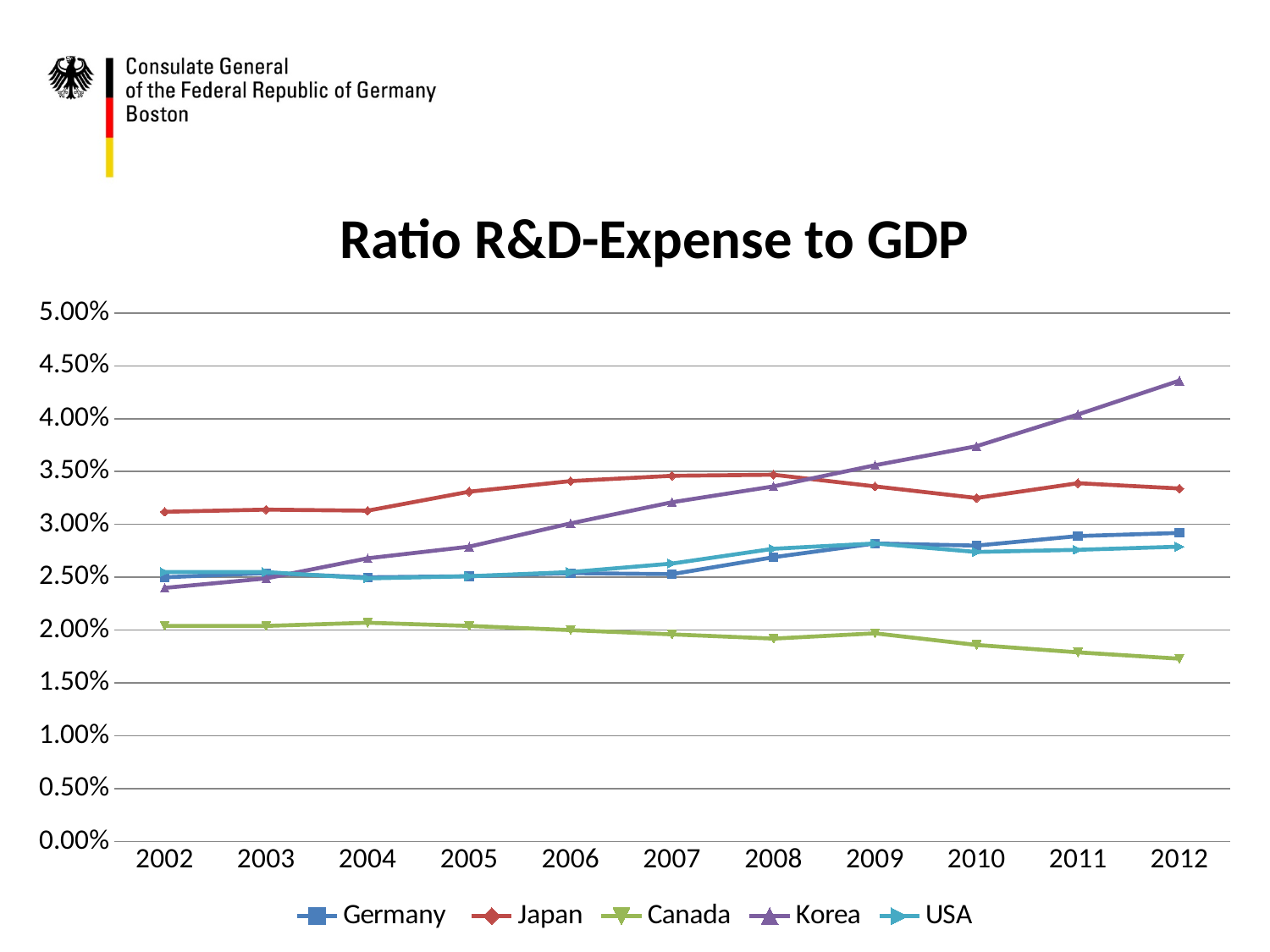
Does the value for Korea rise or fall from 2002 to 2012? rise Which country has the lowest ratio of R&D expense to GDP in 2012? Canada How many years are shown on the x axis? 11 Is the value for Korea in 2012 greater or less than 4.00%? greater Is the value for Japan in 2008 greater or less than 3.00%? greater What kind of chart is shown on the slide? line chart Which country has the highest ratio of R&D expense to GDP in 2002? Japan How many series does the legend list? 5 Does the value for Canada rise or fall from 2004 to 2012? fall Is the value for Canada in 2012 greater or less than 2.00%? less Which country has the highest ratio of R&D expense to GDP in 2012? Korea In 2005, which is larger, the value for Japan or the value for Germany? Japan